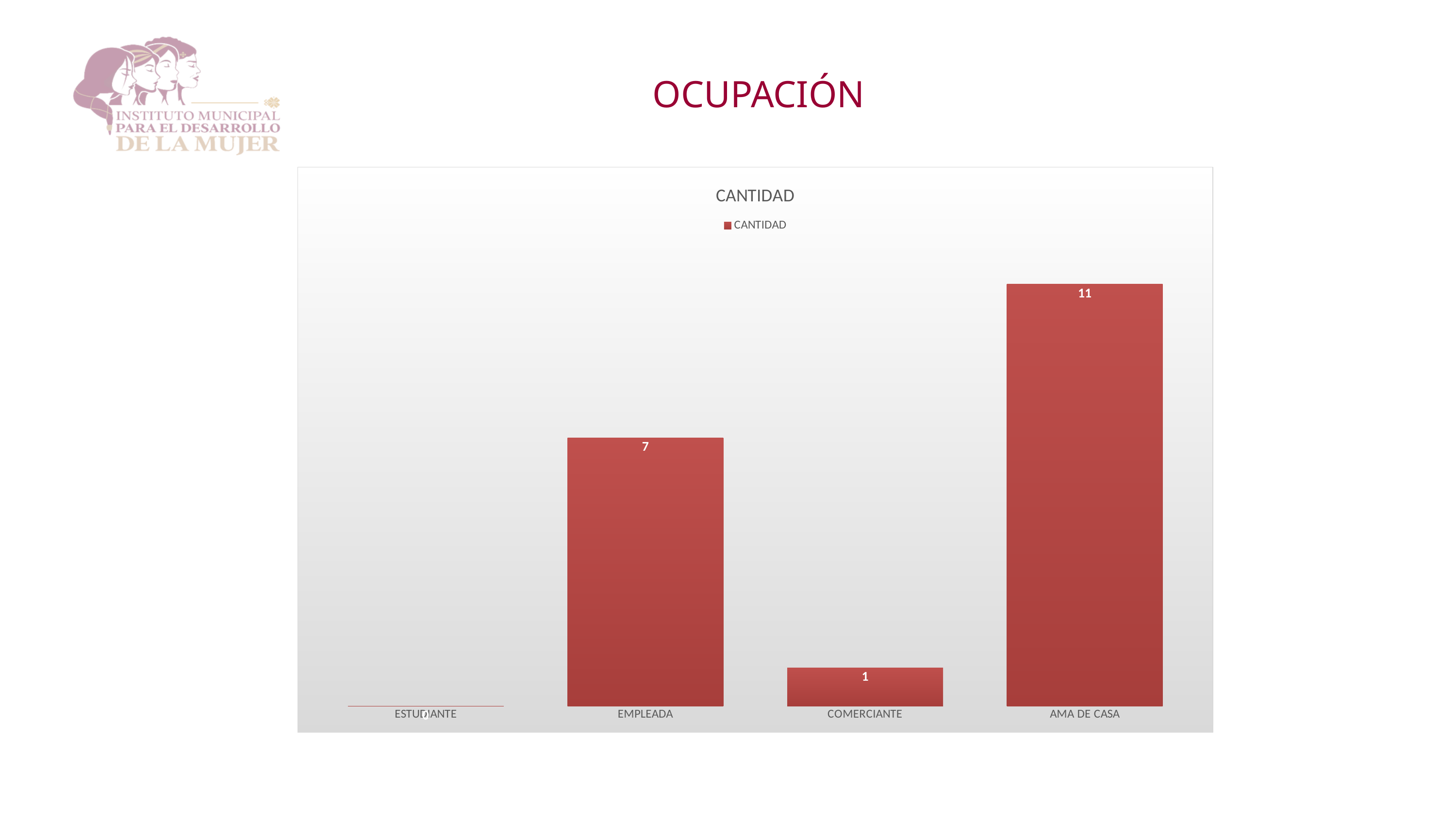
What is the difference between the values for AMA DE CASA and EMPLEADA? 4 What is the value for COMERCIANTE? 1 Which category has the highest value? AMA DE CASA What is the value for AMA DE CASA? 11 What is the title of the chart? CANTIDAD How many categories are shown on the x axis? 4 What is the difference between the values for EMPLEADA and COMERCIANTE? 6 How many series does the legend list? 1 What kind of chart is shown on the slide? bar chart What is the value for EMPLEADA? 7 Which category has the lowest value? ESTUDIANTE Which is larger, the value for EMPLEADA or the value for COMERCIANTE? EMPLEADA